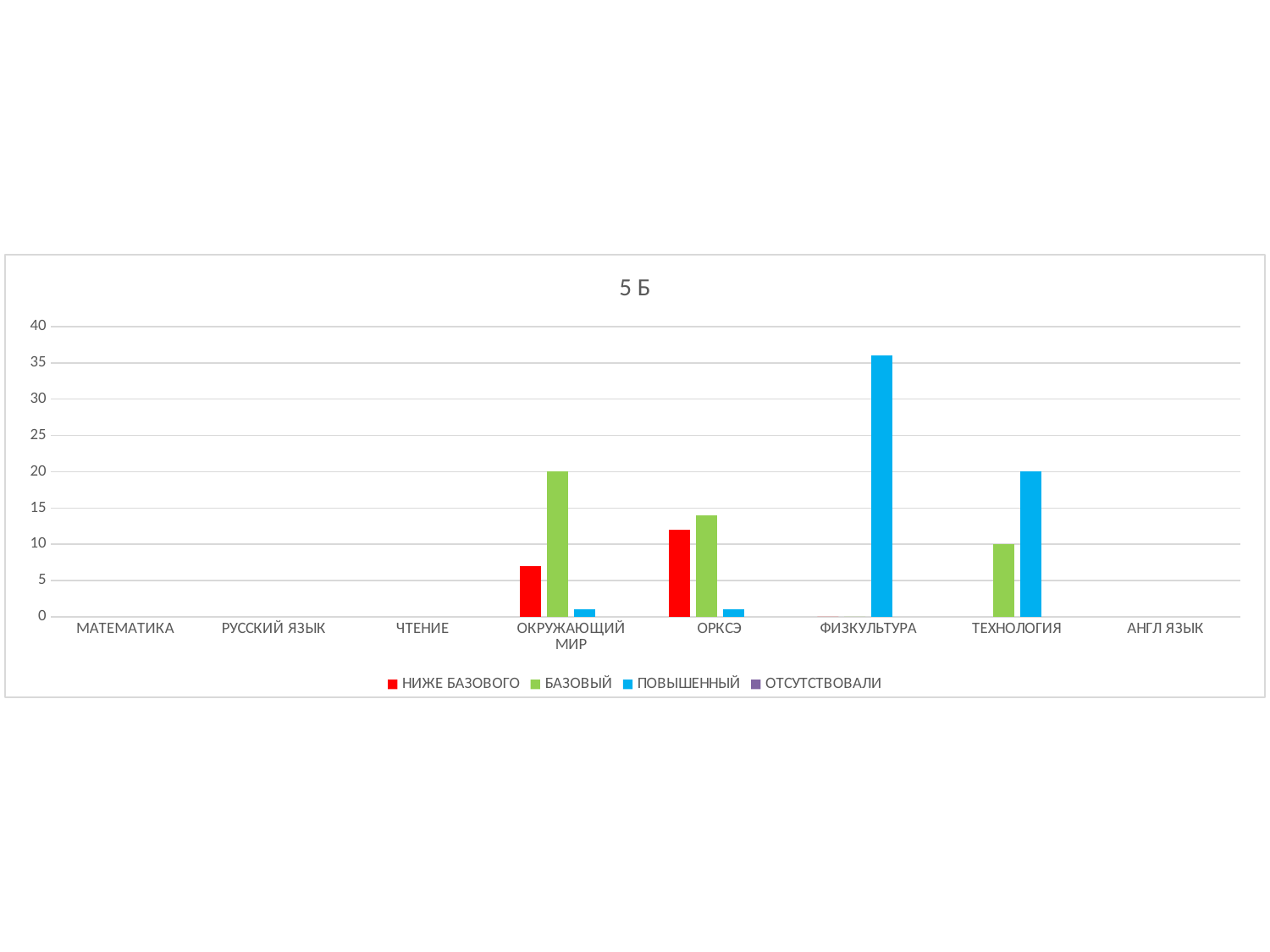
Which category has the highest ПОВЫШЕННЫЙ value? ФИЗКУЛЬТУРА Which is larger for ОРКСЭ: НИЖЕ БАЗОВОГО or ПОВЫШЕННЫЙ? НИЖЕ БАЗОВОГО What is the value of ПОВЫШЕННЫЙ for ТЕХНОЛОГИЯ? 20 How many series does the legend list? 4 What is the value of БАЗОВЫЙ for ОКРУЖАЮЩИЙ МИР? 20 Is the НИЖЕ БАЗОВОГО value for ОКРУЖАЮЩИЙ МИР greater or less than 10? less What is the value of БАЗОВЫЙ for ТЕХНОЛОГИЯ? 10 What is the title of the chart? 5 Б What kind of chart is shown on the slide? bar chart How many categories are shown on the x axis? 8 Which colour represents the ПОВЫШЕННЫЙ series? blue